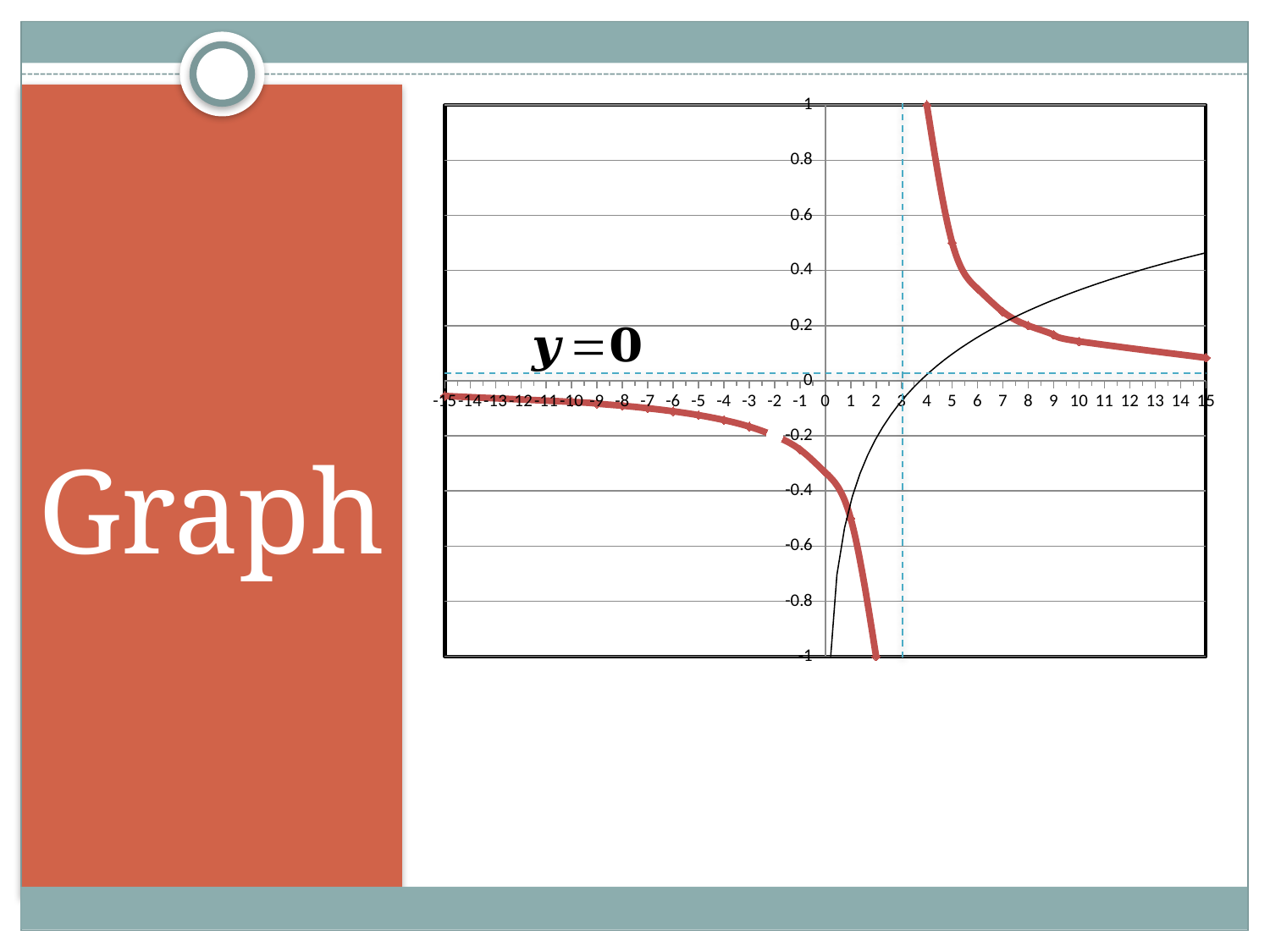
At x = 14, which curve has the larger value, the thick red curve or the thin black curve? the thin black curve Is the value of the thick red curve at x = 4 greater or less than 0.8? greater What is the highest value labelled on the vertical axis of the chart? 1 At x = 5, which curve has the larger value, the thick red curve or the thin black curve? the thick red curve Is the value of the thick red curve at x = 2 greater or less than -0.6? less What is the lowest value labelled on the horizontal axis of the chart? -15 What equation is written as a label next to the horizontal dashed line on the chart? y = 0 Is the value of the thick red curve at x = 10 greater or less than 0.2? less Does the thin black curve rise or fall as x increases from 1 to 15? rise What kind of chart is shown on the slide? line chart For x values greater than 3, does the thick red curve rise or fall as x increases? fall